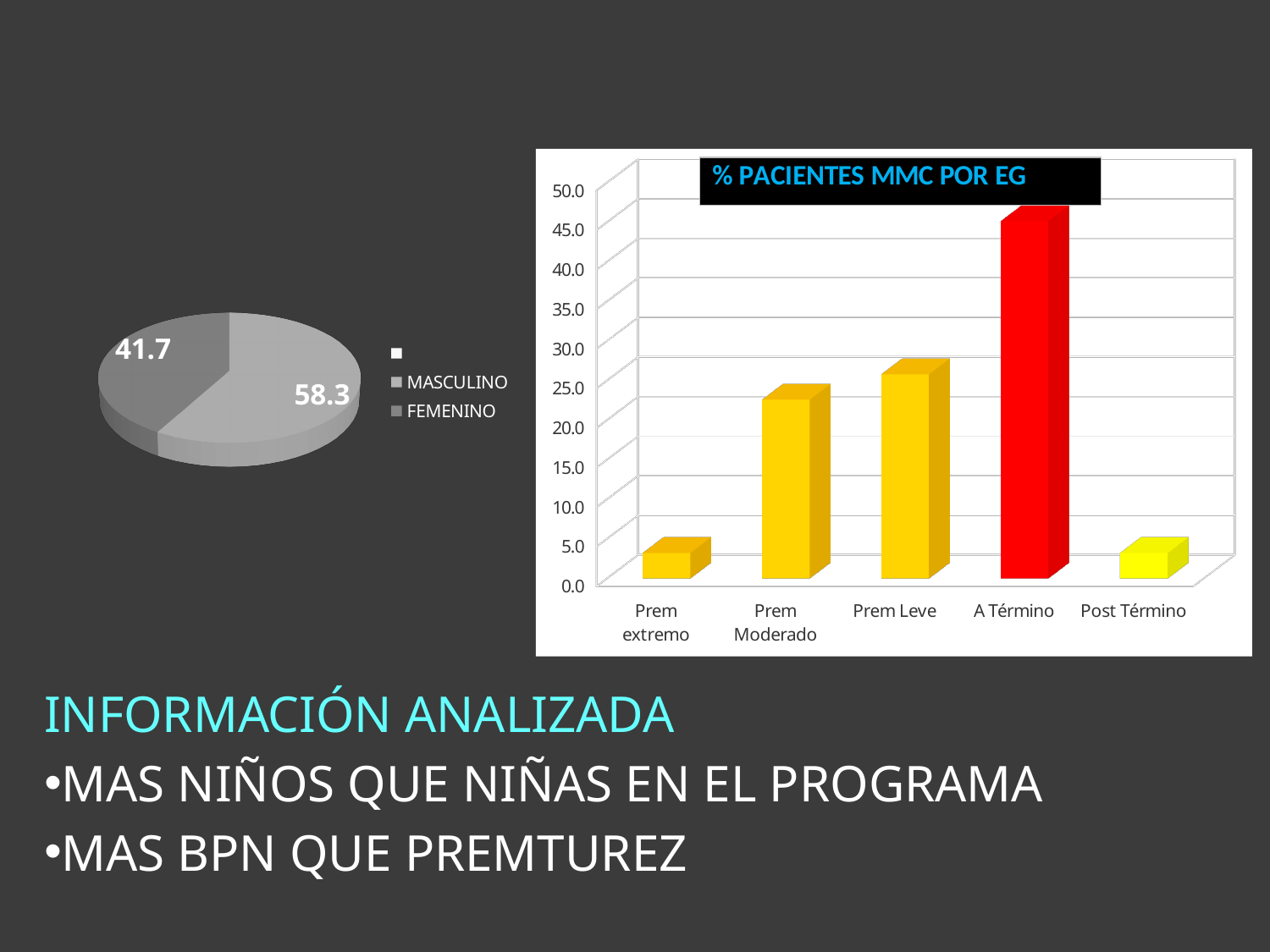
In the pie chart on the left, what is the difference between the two slice values, 58.3 and 41.7? 16.6 In the pie chart on the left, what is the value of the larger slice? 58.3 In the chart titled '% PACIENTES MMC POR EG', which category has the highest value? A Término In the chart titled '% PACIENTES MMC POR EG', which is larger, the value for Prem Leve or the value for Prem Moderado? Prem Leve In the chart titled '% PACIENTES MMC POR EG', is the value for A Término greater or less than 40.0? greater In the chart titled '% PACIENTES MMC POR EG', how many categories are shown on the x axis? 5 In the chart titled '% PACIENTES MMC POR EG', is the value for Prem extremo greater or less than 5.0? less What is the title of the bar chart on the right of the slide? % PACIENTES MMC POR EG What type of chart is the chart on the left of the slide? pie chart What type of chart is the chart titled '% PACIENTES MMC POR EG'? bar chart In the chart titled '% PACIENTES MMC POR EG', is the value for Prem Moderado greater or less than 20.0? greater